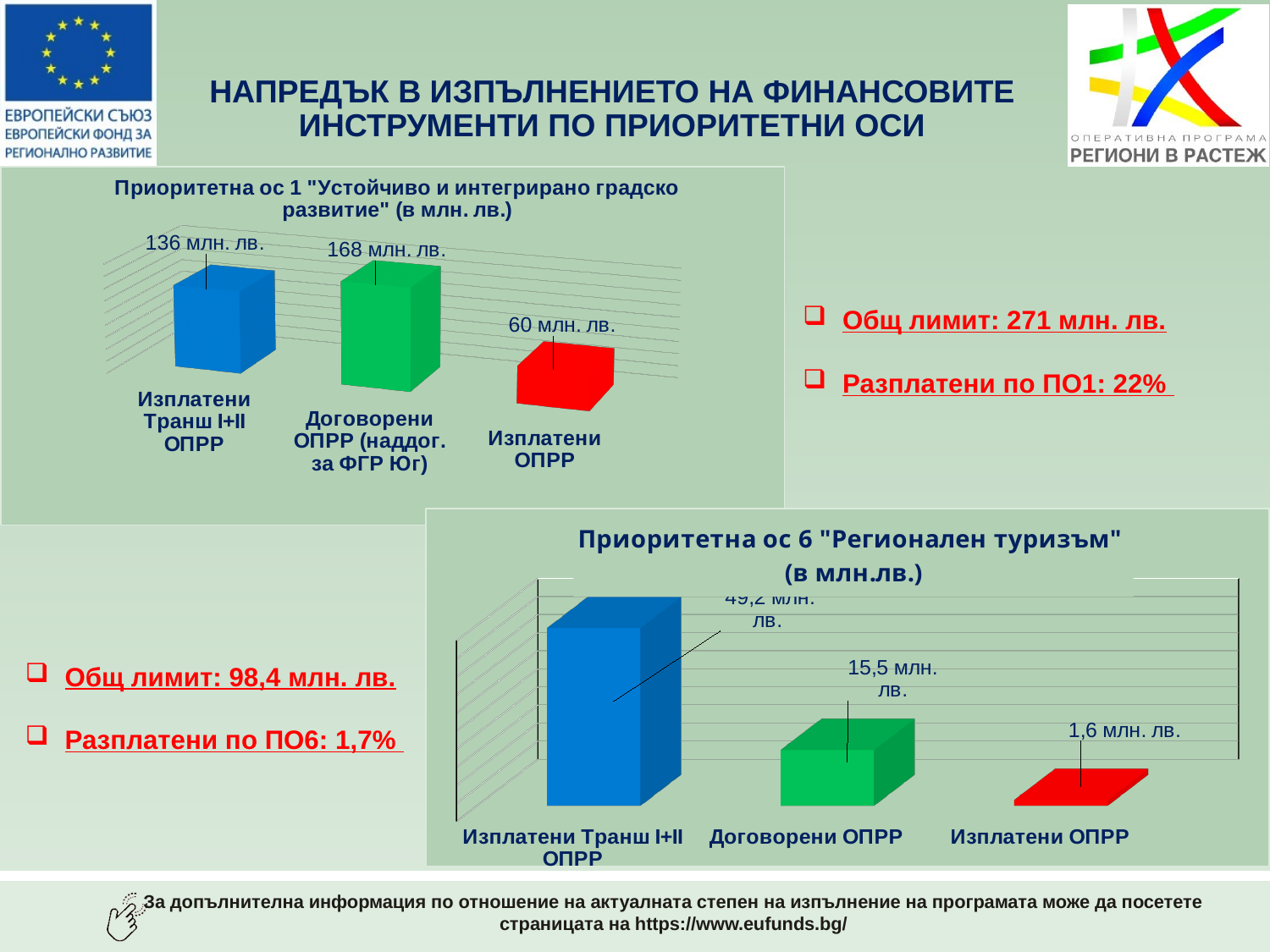
In the chart for Приоритетна ос 6 "Регионален туризъм", what is the value for Изплатени ОПРР? 1,6 млн. лв. In the chart for Приоритетна ос 1, which category has the lowest value? Изплатени ОПРР In the chart for Приоритетна ос 1, what is the value for Изплатени ОПРР? 60 млн. лв. What type of chart is used for Приоритетна ос 1? Bar chart In the chart for Приоритетна ос 1, what is the value for Изплатени Транш I+II ОПРР? 136 млн. лв. In the chart for Приоритетна ос 6 "Регионален туризъм", which category has the highest value? Изплатени Транш I+II ОПРР In the chart for Приоритетна ос 1, what is the difference between Договорени ОПРР (наддог. за ФГР Юг) and Изплатени Транш I+II ОПРР? 32 млн. лв. In the chart for Приоритетна ос 1, what is the value for Договорени ОПРР (наддог. за ФГР Юг)? 168 млн. лв. How many categories are shown in the chart for Приоритетна ос 6 "Регионален туризъм"? 3 In the chart for Приоритетна ос 1, which category has the highest value? Договорени ОПРР (наддог. за ФГР Юг) In the chart for Приоритетна ос 6 "Регионален туризъм", what is the value for Договорени ОПРР? 15,5 млн. лв. In the chart for Приоритетна ос 6 "Регионален туризъм", which is larger: Договорени ОПРР or Изплатени ОПРР? Договорени ОПРР